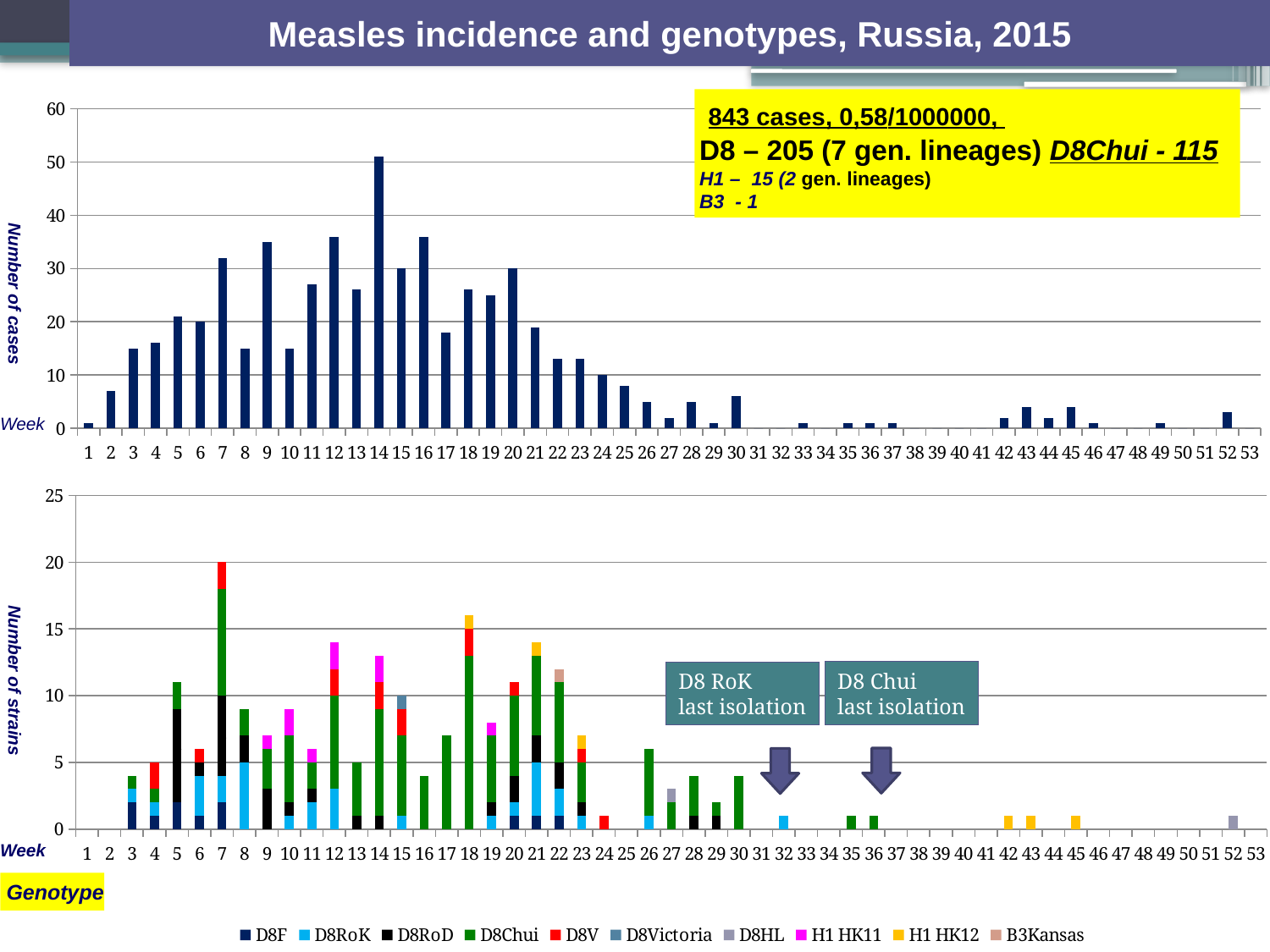
In the top chart (Number of cases), do the values rise or fall from week 14 to week 30? fall In the bottom chart (Number of strains), is the total for week 7 greater or less than 15? greater In the top chart (Number of cases), which week has the highest number of cases? 14 How many series does the legend of the bottom chart (Number of strains) list? 10 What kind of chart is the top chart (Number of cases)? bar chart In the legend of the bottom chart, which genotype is shown in green? D8Chui In the top chart (Number of cases), which has more cases, week 7 or week 8? Week 7 In the top chart (Number of cases), is the value for week 14 greater or less than 40? greater In the bottom chart (Number of strains), which week has the tallest stacked bar? 7 In the top chart (Number of cases), is the value for week 1 greater or less than 10? less How many weeks are shown on the x axis of the top chart? 53